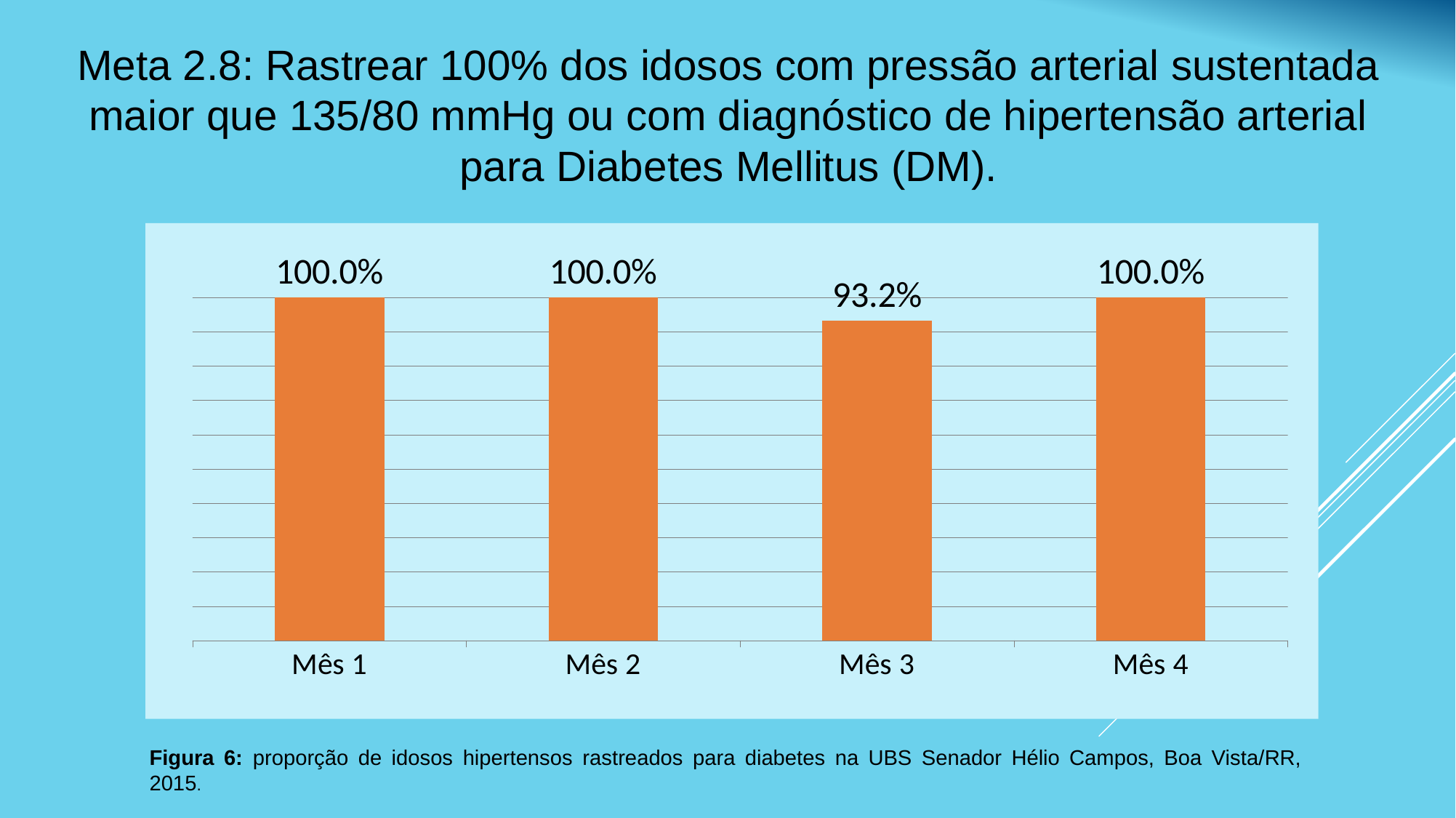
What is the value for Mês 3? 93.2% Which is larger, the value for Mês 3 or the value for Mês 4? Mês 4 What kind of chart is shown on the slide? Bar chart What colour are the bars in the chart? Orange What figure number is given in the caption below the chart? Figura 6 Which month has the lowest value? Mês 3 What is the difference between the values for Mês 2 and Mês 3? 6.8% How many months are shown on the x axis? 4 How many months reach 100.0%? 3 What is the value for Mês 4? 100.0% Do the values for Mês 1 and Mês 2 differ? No What is the value for Mês 1? 100.0%